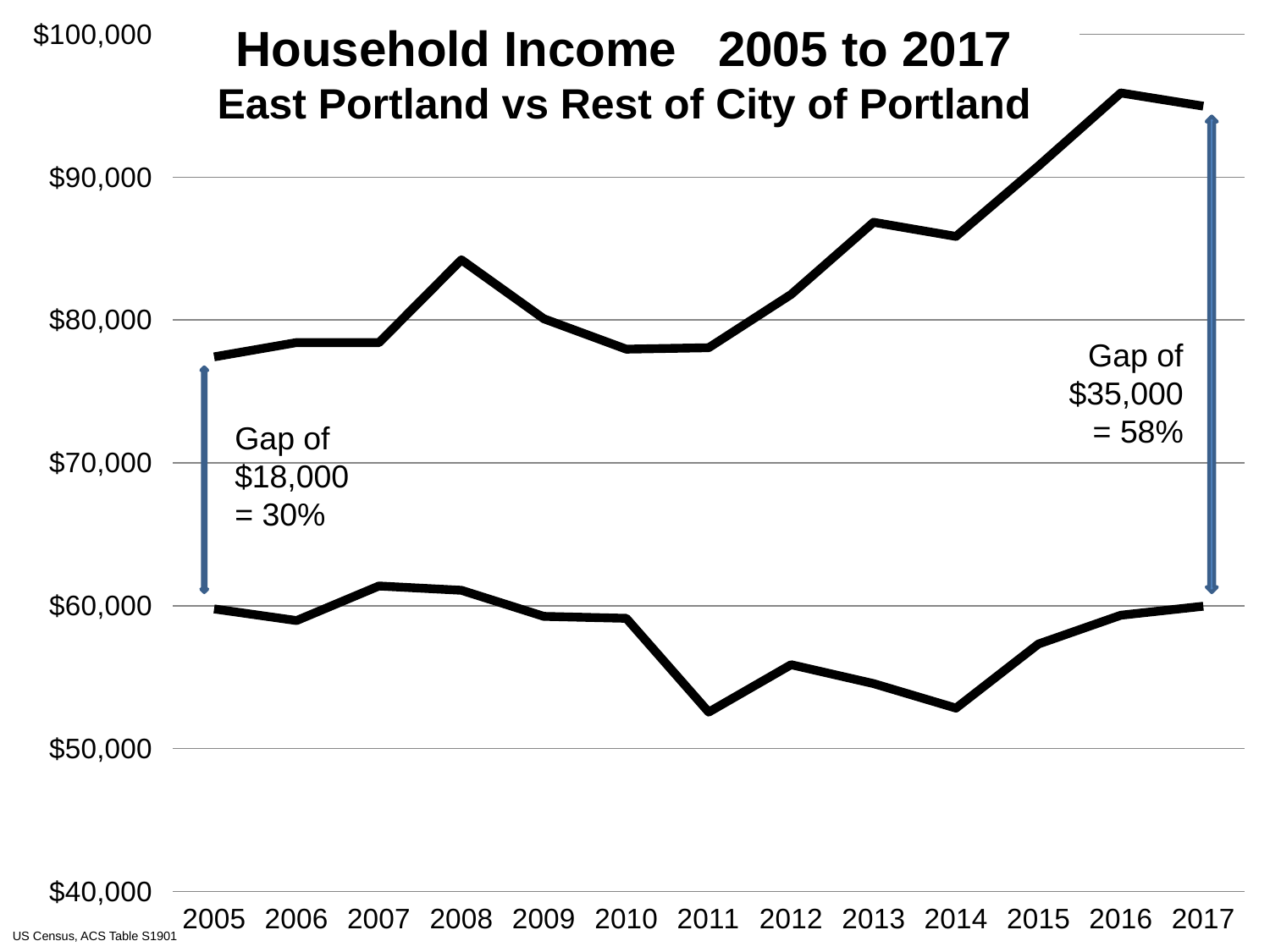
Is the value of the lower line in 2011 greater or less than $60,000? less Is the value of the upper line in 2016 greater or less than $90,000? greater What kind of chart is shown on the slide? line chart Is the value of the upper line in 2008 greater or less than $80,000? greater In which year does the upper line reach its highest value? 2016 What gap in household income does the chart annotate for 2017? $35,000 = 58% What is the title of the chart? Household Income 2005 to 2017 East Portland vs Rest of City of Portland How many years are plotted along the x axis? 13 For the upper line, which year has the larger value, 2008 or 2009? 2008 Does the upper line rise or fall from 2014 to 2016? rise What gap in household income does the chart annotate for 2005? $18,000 = 30%